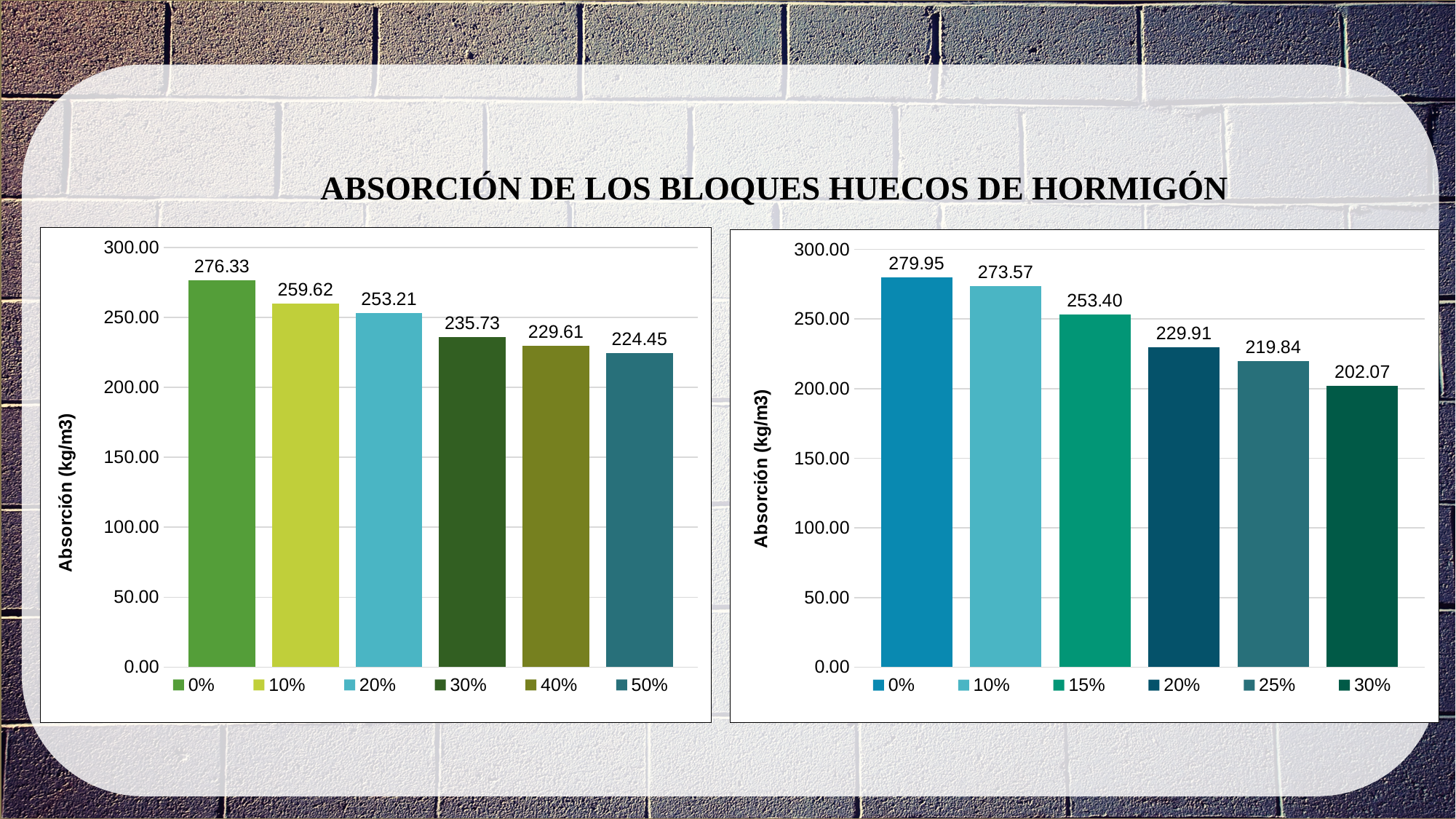
In the left chart, which category has the highest absorption? 0% In the right chart, what is the difference between the values for 0% and 30%? 77.88 In the left chart, what is the absorption value for 0%? 276.33 In the right chart, what is the absorption value for 15%? 253.40 In the left chart, is the value for 30% greater or less than 250.00? less In the right chart, which category has the lowest absorption? 30% How many bars are shown in the right chart? 6 In the left chart, what is the absorption value for 40%? 229.61 What type of chart is the left chart? bar chart In the left chart, what is the difference between the values for 0% and 50%? 51.88 In the right chart, which is larger, the value for 10% or the value for 20%? 10% In the right chart, do the values rise or fall from left to right along the x axis? fall